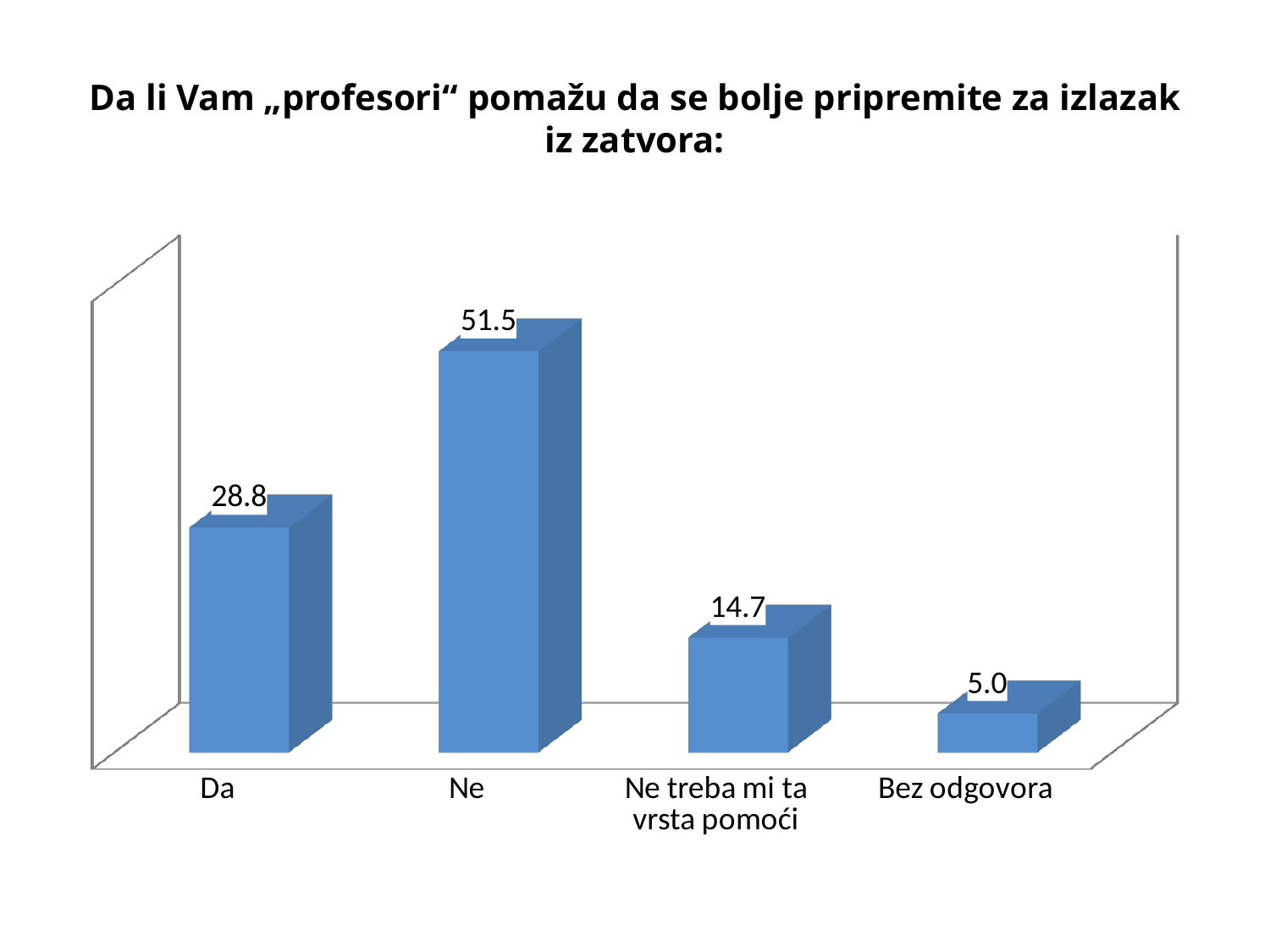
Which category has the highest value? Ne Which is larger, the value for "Da" or the value for "Ne treba mi ta vrsta pomoći"? Da Which category has the lowest value? Bez odgovora What is the value for "Da"? 28.8 What is the value for "Bez odgovora"? 5.0 What is the value for "Ne treba mi ta vrsta pomoći"? 14.7 How many categories are shown on the chart? 4 What is the value for "Ne"? 51.5 What kind of chart is shown on the slide? Bar chart What is the difference between the values for "Ne treba mi ta vrsta pomoći" and "Bez odgovora"? 9.7 What is the difference between the values for "Ne" and "Da"? 22.7 What is the title of the chart? Da li Vam „profesori“ pomažu da se bolje pripremite za izlazak iz zatvora: